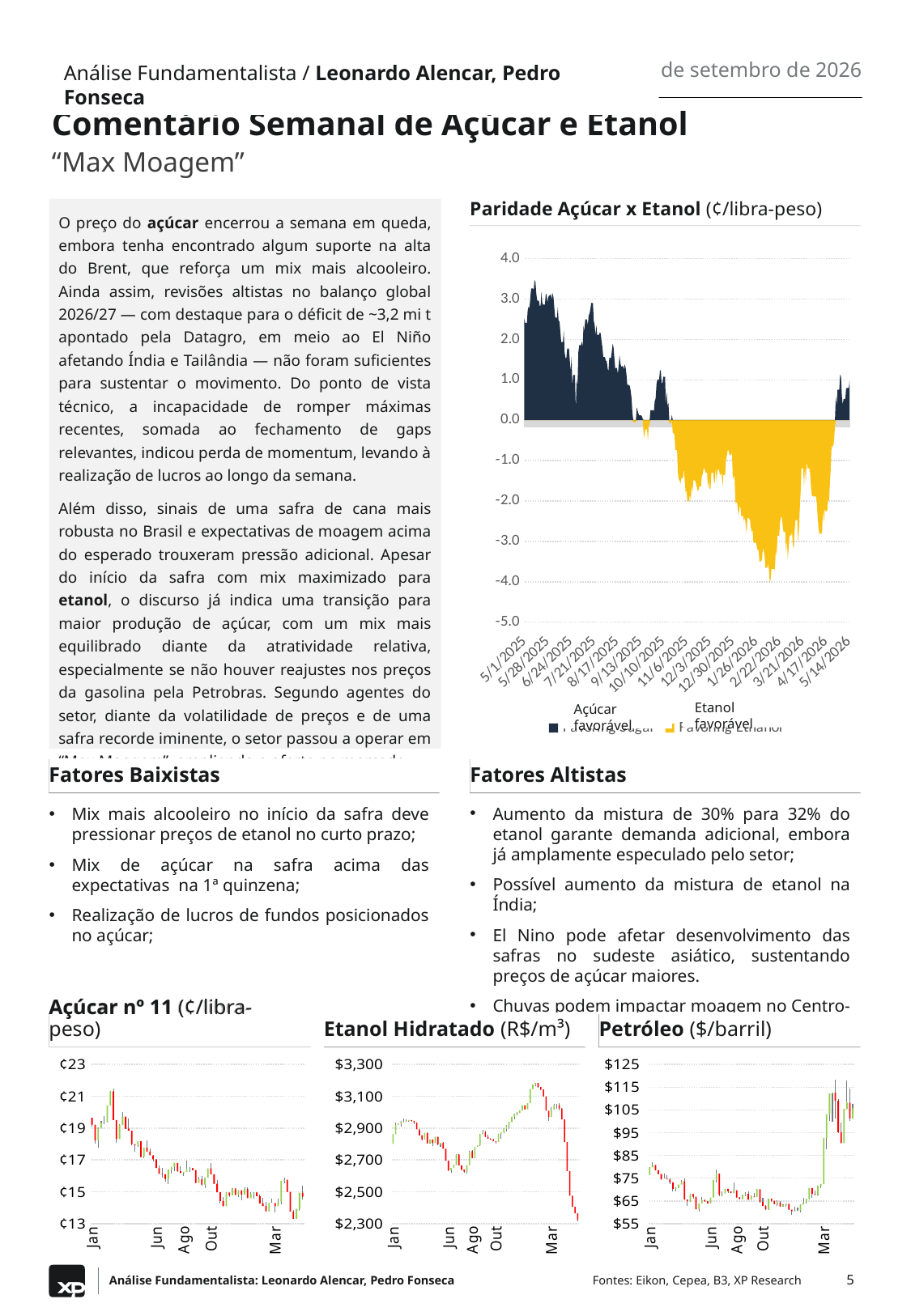
What unit is given in the title of the 'Petróleo' chart? $/barril In the 'Paridade Açúcar x Etanol' chart, do the values generally rise or fall between 5/1/2025 and 11/6/2025? fall In the 'Paridade Açúcar x Etanol' chart, is the value around 2/22/2026 greater or less than -1.0? less How many charts are shown on the slide? 4 What kind of chart is the 'Paridade Açúcar x Etanol' chart? area chart In the 'Petróleo' chart, is the last plotted price greater or less than $95? greater In the 'Paridade Açúcar x Etanol' chart, which legend entry is shown in yellow? Etanol favorável In the 'Etanol Hidratado' chart, is the last plotted price greater or less than $2,500? less In the 'Paridade Açúcar x Etanol' chart, how many series does the legend list? 2 In the 'Açúcar nº 11' chart, do prices generally rise or fall from Jan to Mar? fall